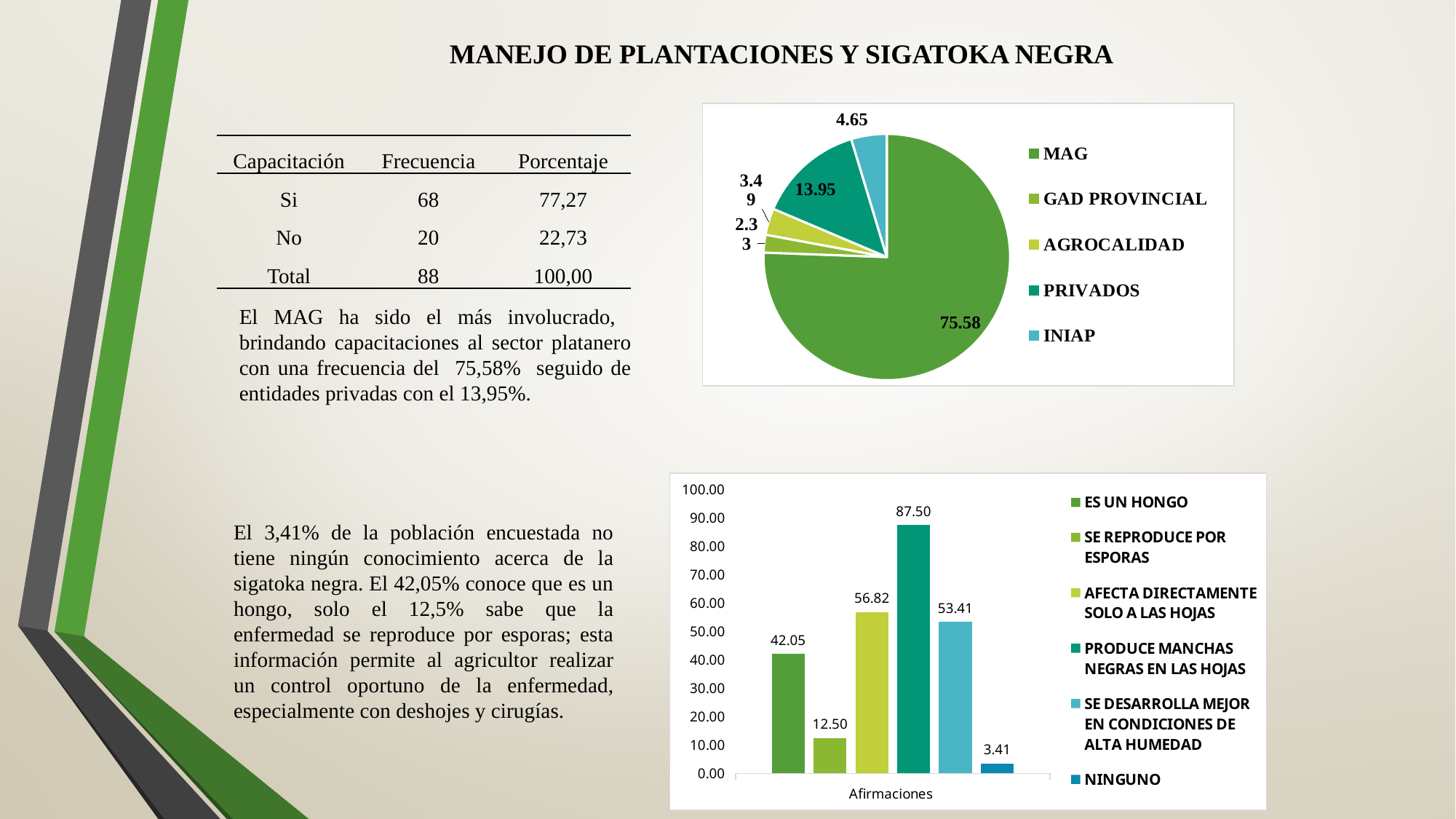
What type of chart is shown at the bottom right of the slide? Bar chart In the bar chart at the bottom right, what is the value for PRODUCE MANCHAS NEGRAS EN LAS HOJAS? 87.50 In the pie chart at the top right, which category has the largest slice? MAG In the pie chart at the top right, what is the value for MAG? 75.58 In the bar chart at the bottom right, which is larger: AFECTA DIRECTAMENTE SOLO A LAS HOJAS or SE DESARROLLA MEJOR EN CONDICIONES DE ALTA HUMEDAD? AFECTA DIRECTAMENTE SOLO A LAS HOJAS In the pie chart at the top right, how many categories does the legend list? 5 In the pie chart at the top right, what is the difference between the values for MAG and PRIVADOS? 61.63 In the bar chart at the bottom right, how many series does the legend list? 6 In the bar chart at the bottom right, which category has the lowest value? NINGUNO In the bar chart at the bottom right, what is the value for SE REPRODUCE POR ESPORAS? 12.50 In the pie chart at the top right, what is the value for PRIVADOS? 13.95 In the pie chart at the top right, what is the value for INIAP? 4.65